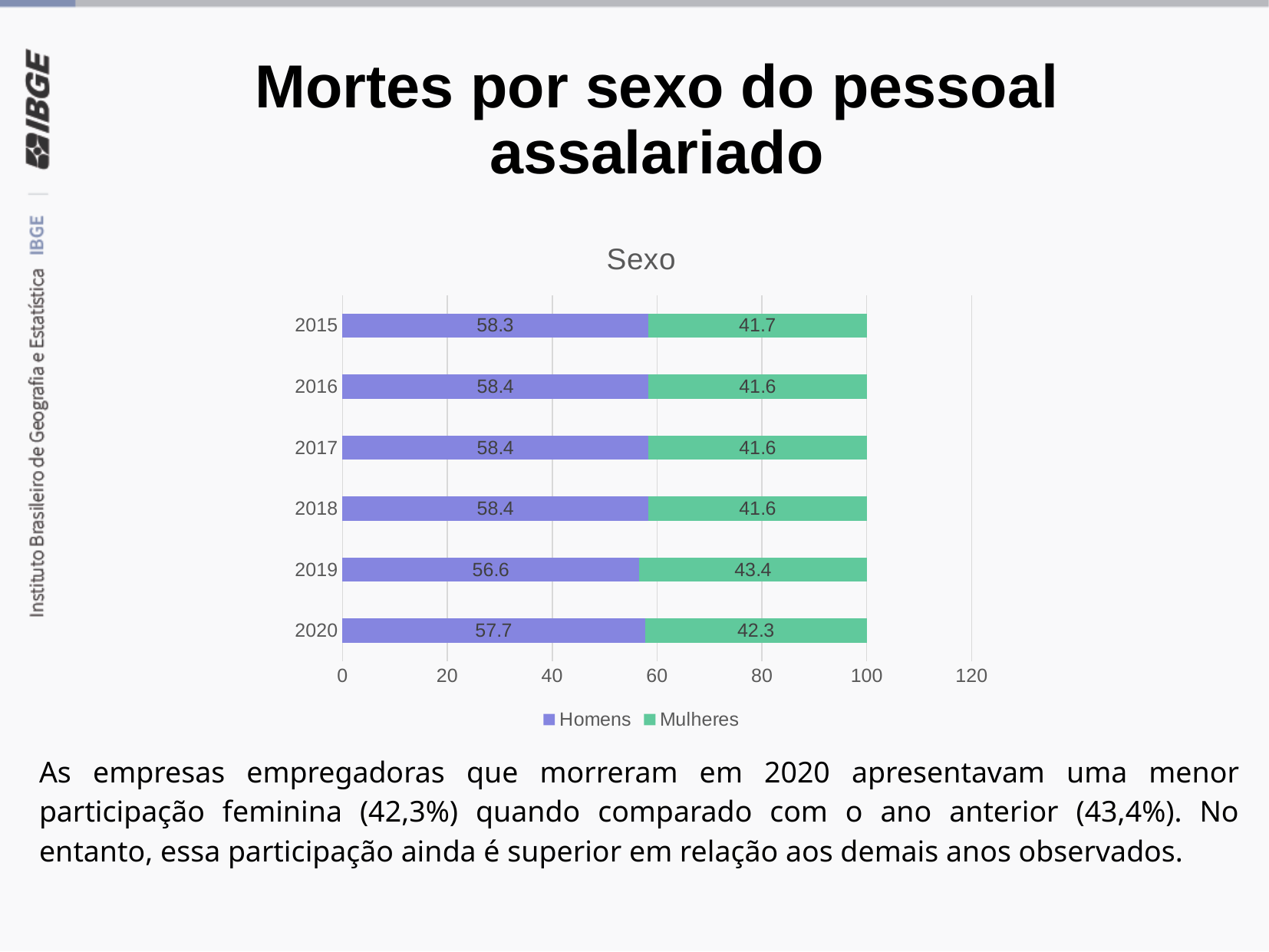
What is the value for Homens in 2020? 57.7 What is the total of the stacked bar for 2018? 100 How many years are shown on the chart? 6 What is the difference between the Homens and Mulheres values in 2020? 15.4 In which year is the Homens value lowest? 2019 What is the value for Mulheres in 2019? 43.4 How many series does the legend list? 2 What is the value for Homens in 2015? 58.3 In which year is the Mulheres value highest? 2019 What kind of chart is shown on the slide? Stacked bar chart What is the value for Mulheres in 2020? 42.3 Which is larger in 2019, the Homens value or the Mulheres value? Homens